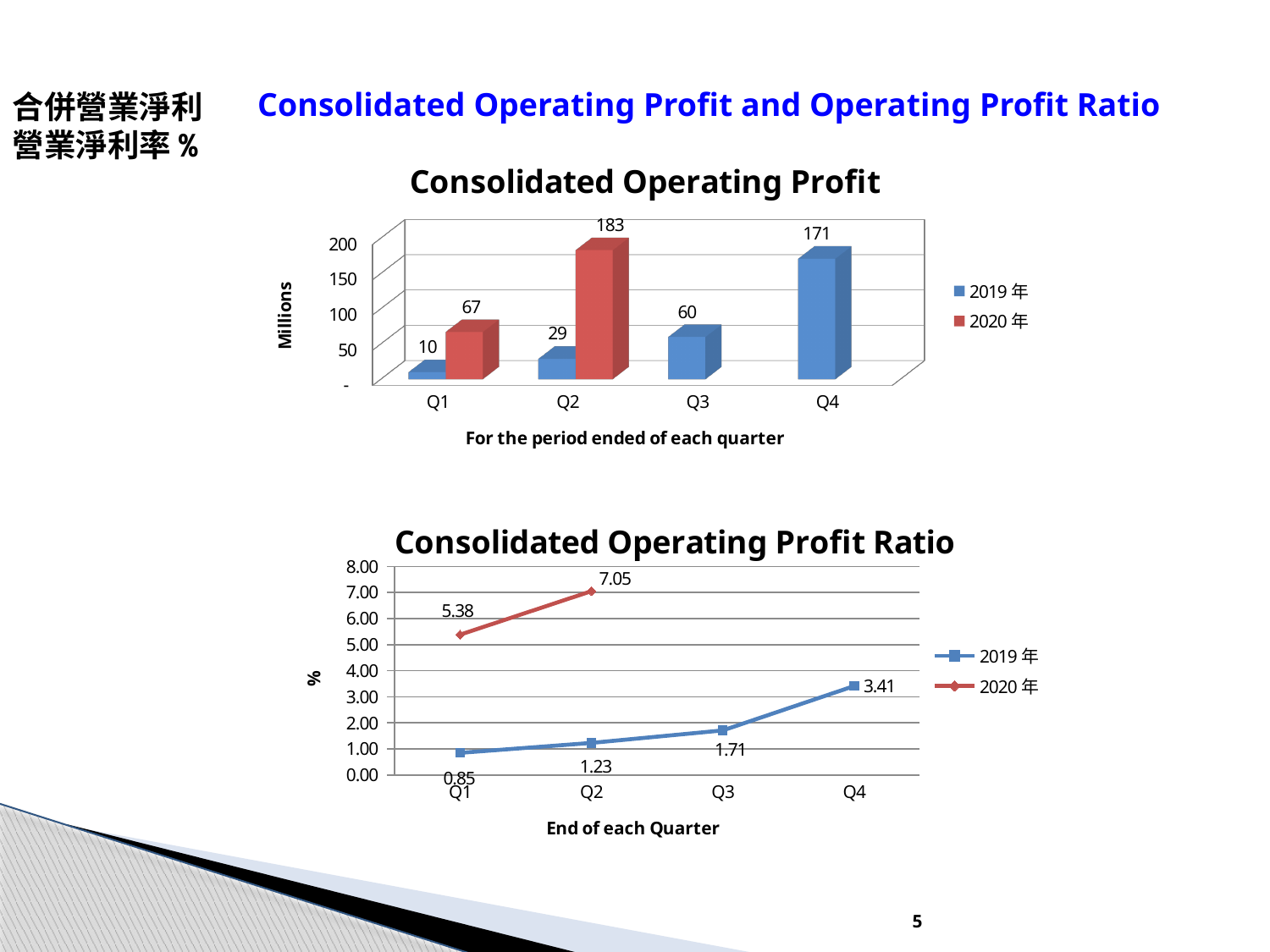
What kind of chart is the Consolidated Operating Profit Ratio chart? Line chart How many series does the legend of the Consolidated Operating Profit chart list? 2 In the Consolidated Operating Profit Ratio chart, what is the difference between the 2020 年 values for Q2 and Q1? 1.67 In the Consolidated Operating Profit chart, what is the difference between the 2020 年 and 2019 年 values for Q1? 57 What kind of chart is the Consolidated Operating Profit chart? Bar chart In the Consolidated Operating Profit Ratio chart, does the 2019 年 series rise or fall from Q1 to Q4? Rise In the Consolidated Operating Profit Ratio chart, what is the 2020 年 value for Q2? 7.05 In the Consolidated Operating Profit chart, what is the 2019 年 value for Q4? 171 In the Consolidated Operating Profit chart, which is larger for Q2: the 2019 年 value or the 2020 年 value? 2020 年 In the Consolidated Operating Profit chart, what is the 2020 年 value for Q2? 183 In the Consolidated Operating Profit Ratio chart, what is the 2019 年 value for Q3? 1.71 In the Consolidated Operating Profit chart, which quarter has the lowest 2019 年 value? Q1